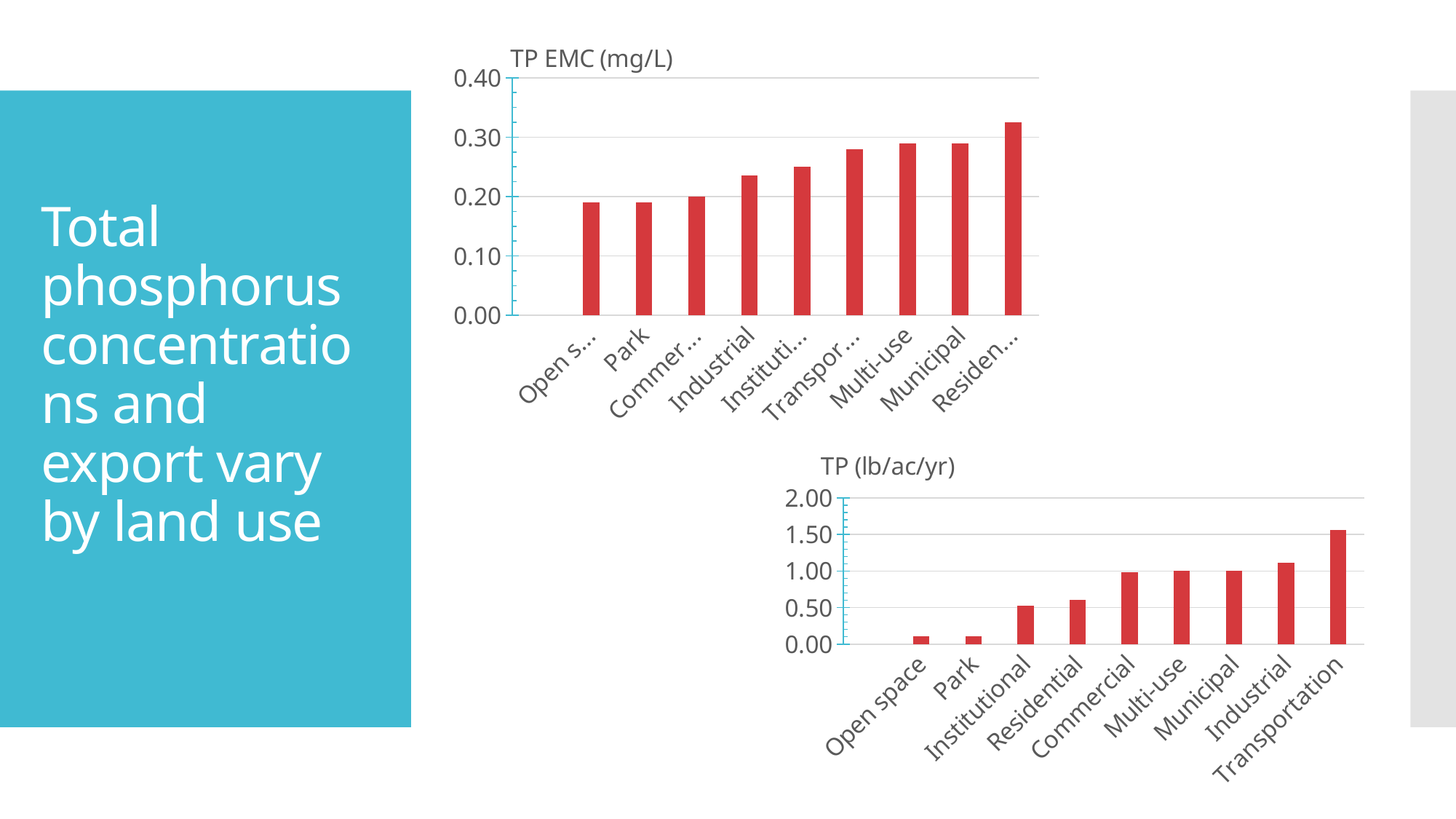
In the bottom chart titled "TP (lb/ac/yr)", is the value for Transportation greater or less than 1.50? greater How many land-use categories are shown in the bottom chart titled "TP (lb/ac/yr)"? 9 In the bottom chart titled "TP (lb/ac/yr)", is the value for Open space greater or less than 0.50? less In the bottom chart titled "TP (lb/ac/yr)", do the values generally rise or fall from left to right along the x axis? rise What colour are the bars in the top chart titled "TP EMC (mg/L)"? red In the top chart titled "TP EMC (mg/L)", which is larger, the value for Industrial or the value for Park? Industrial In the top chart titled "TP EMC (mg/L)", is the value for Municipal greater or less than 0.20? greater What kind of chart is the top chart titled "TP EMC (mg/L)"? bar chart In the bottom chart titled "TP (lb/ac/yr)", which land use has the highest value? Transportation In the bottom chart titled "TP (lb/ac/yr)", which is larger, the value for Industrial or the value for Institutional? Industrial